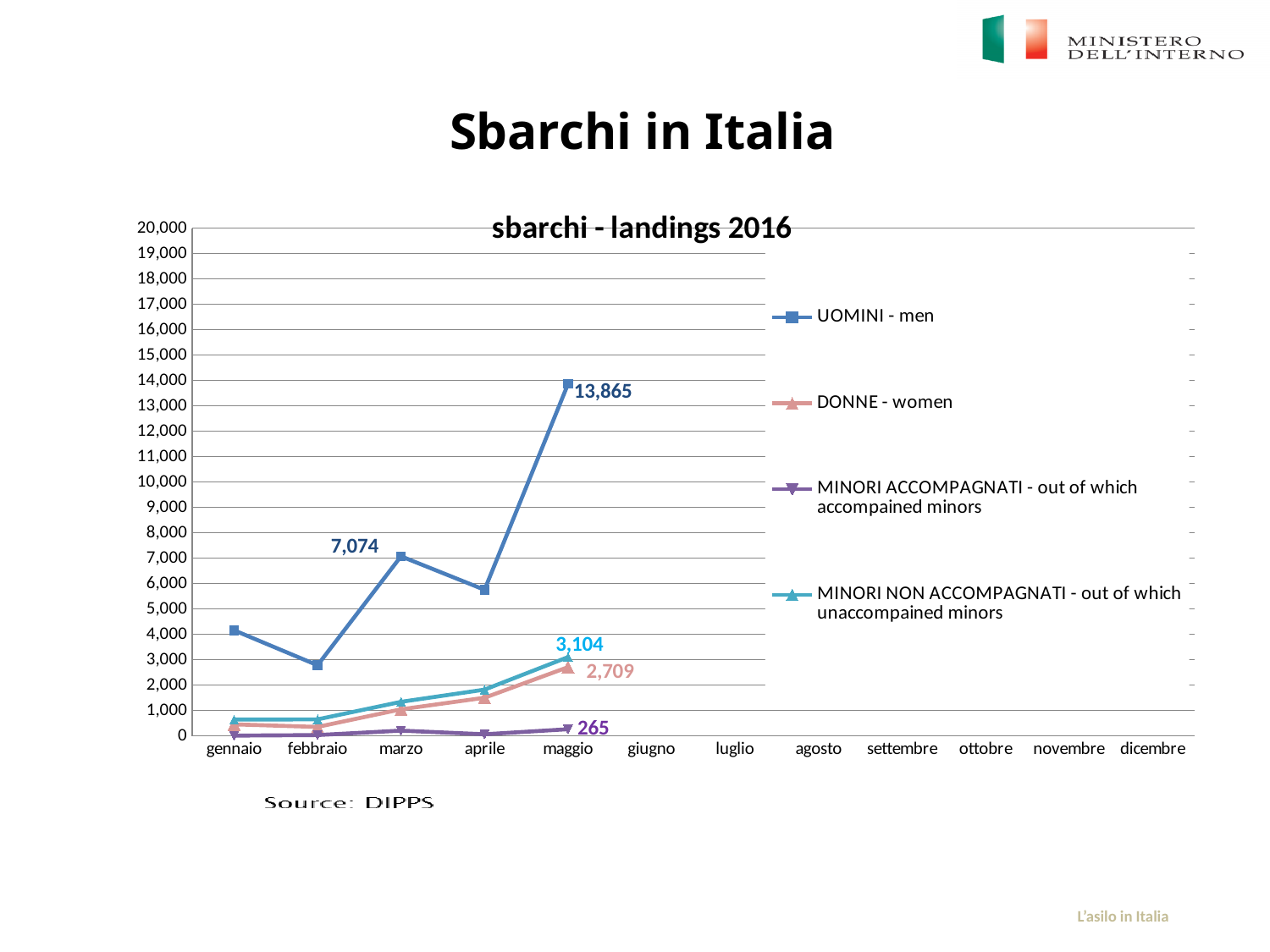
Which series has the lowest value in maggio? MINORI ACCOMPAGNATI - out of which accompained minors What is the difference between the UOMINI - men values in maggio and marzo? 6,791 What is the value for MINORI NON ACCOMPAGNATI - unaccompanied minors in maggio? 3,104 What is the value for UOMINI - men in maggio? 13,865 Which series has the highest value in maggio? UOMINI - men What is the title of the chart? sbarchi - landings 2016 What is the value for MINORI ACCOMPAGNATI - accompanied minors in maggio? 265 What type of chart is shown on the slide? line chart Is the value for UOMINI - men in febbraio greater or less than 4,000? less What is the value for DONNE - women in maggio? 2,709 What is the value for UOMINI - men in marzo? 7,074 How many series does the legend list? 4